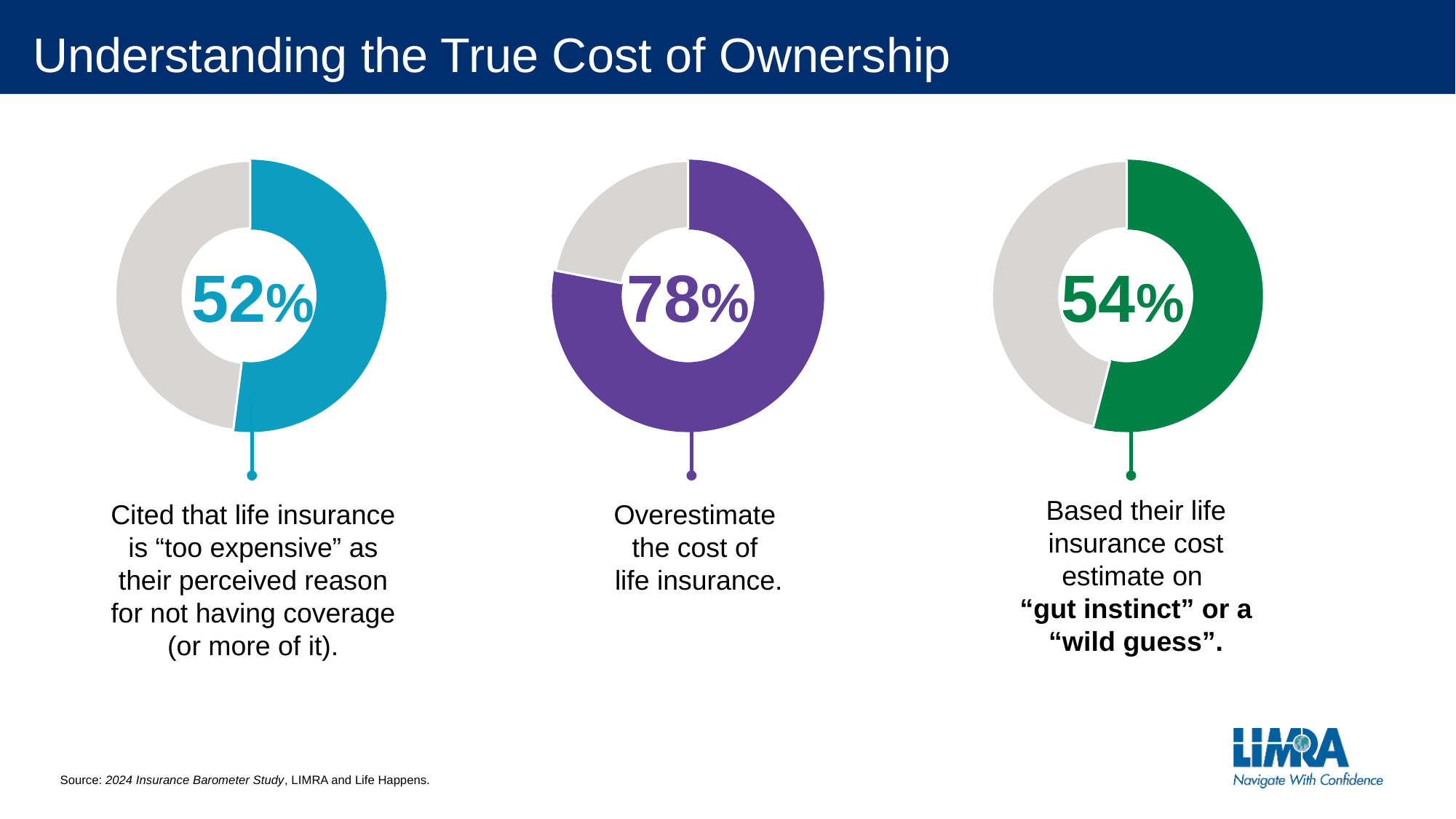
What is the difference between the percentage on the middle chart and the percentage on the left chart? 26 percentage points On the right chart, what percentage based their life insurance cost estimate on "gut instinct" or a "wild guess"? 54% On the middle chart, what percentage overestimate the cost of life insurance? 78% What is the title of the slide containing the three donut charts? Understanding the True Cost of Ownership Which of the three charts on the slide shows the lowest percentage? The left chart (52%) How many donut charts are shown on the slide? 3 What kind of chart is used to display the percentages on this slide? Donut (pie) chart Which of the three charts on the slide shows the highest percentage? The middle chart (78%) What colour is the highlighted segment of the middle chart? Purple Is the percentage on the middle chart larger or smaller than the percentage on the right chart? Larger What is the difference between the percentage on the right chart and the percentage on the left chart? 2 percentage points On the left chart, what percentage cited that life insurance is "too expensive" as their perceived reason for not having coverage? 52%